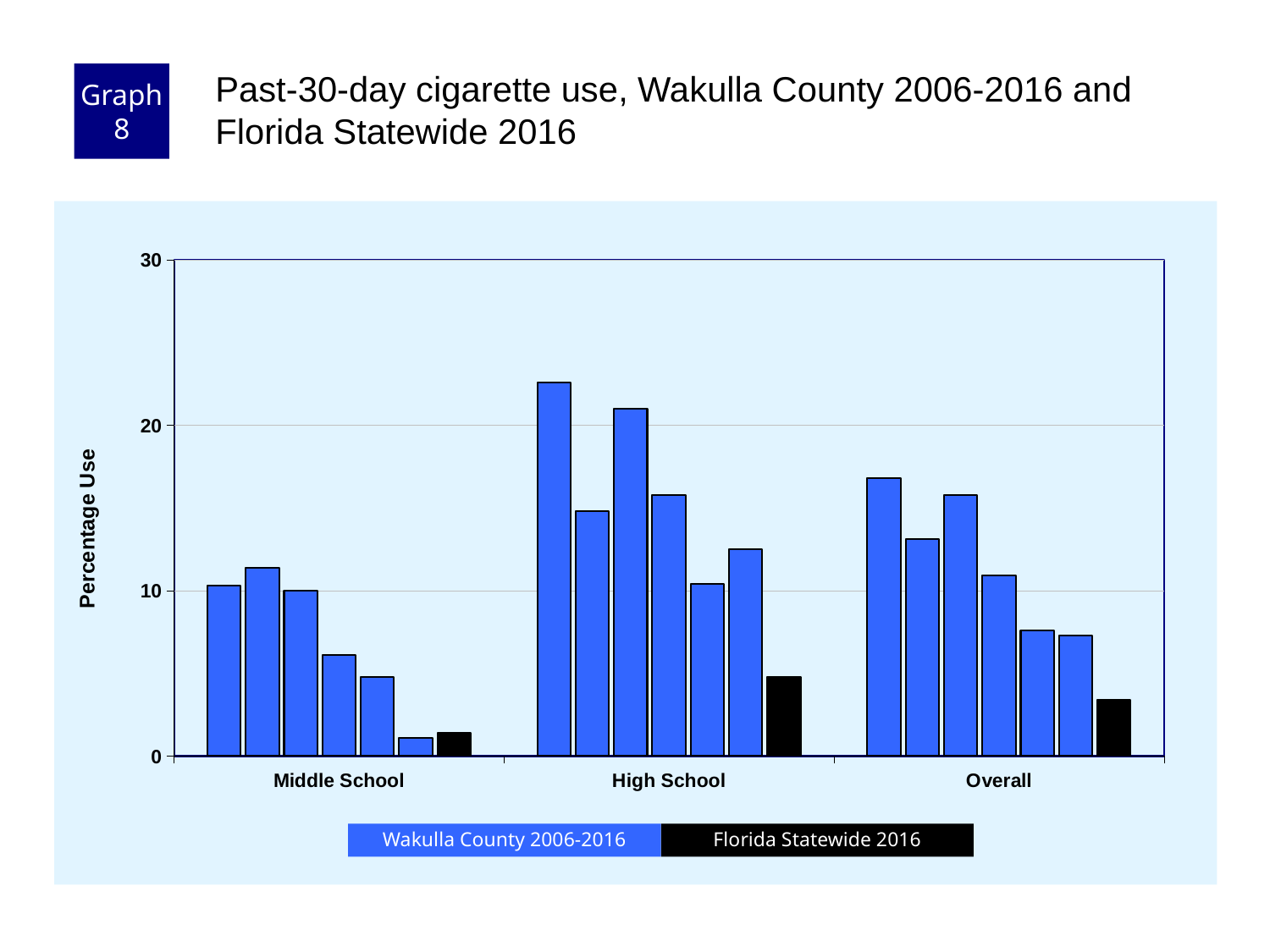
What colour are the Florida Statewide 2016 bars? black What is the label of the y axis? Percentage Use What kind of chart is shown on the slide? bar chart Which is larger: the Florida Statewide 2016 bar for High School or the Florida Statewide 2016 bar for Middle School? High School How many series does the legend list? 2 Is the tallest Wakulla County bar for High School greater or less than 20? greater Is the Florida Statewide 2016 value for High School greater or less than 10? less Which category has the tallest bar overall? High School Is the tallest Wakulla County bar for Middle School greater or less than 20? less How many categories are shown on the x axis? 3 Do the Wakulla County bars for Middle School generally rise or fall from left to right? fall